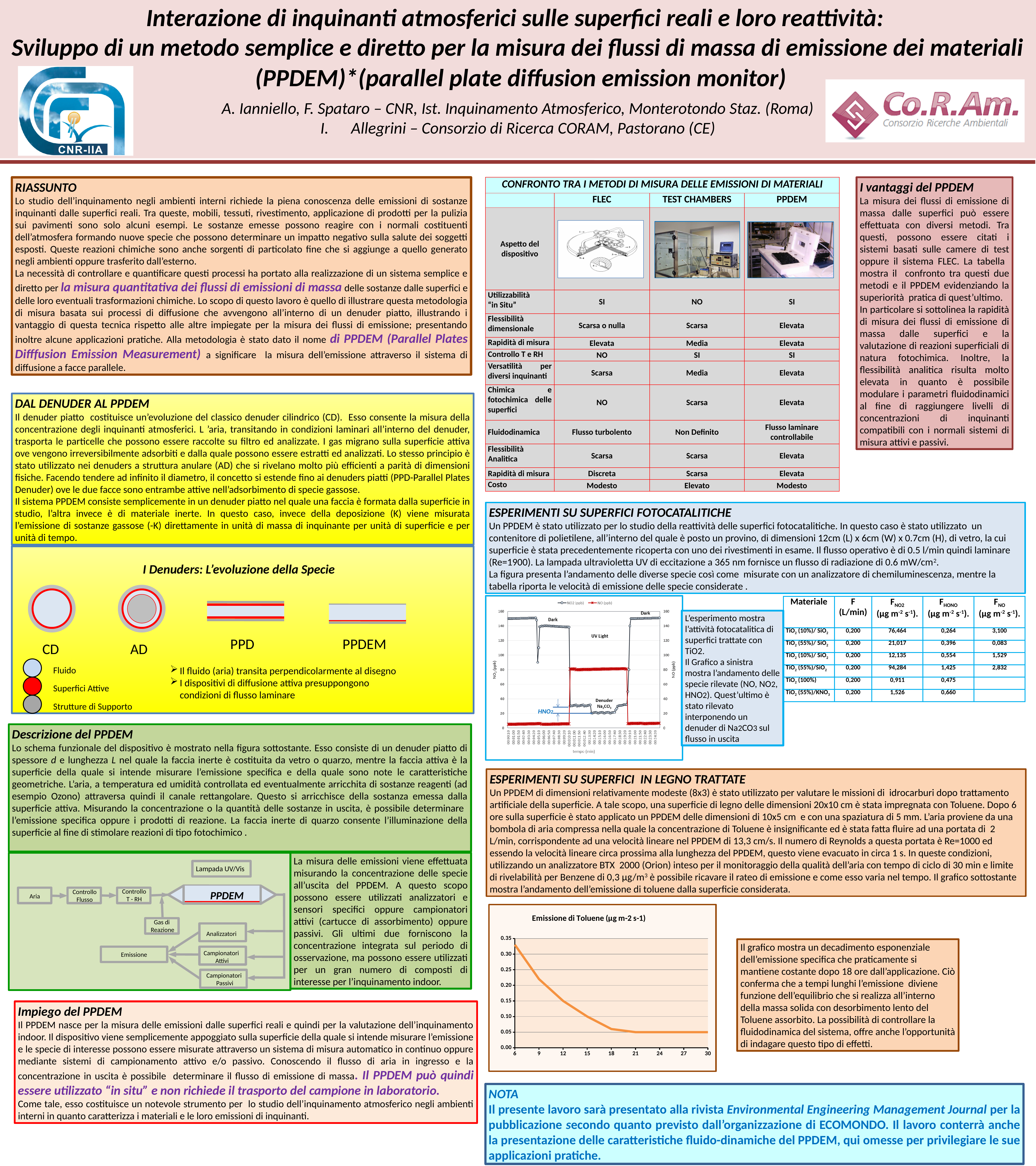
In the 'Emissione di Toluene (µg m-2 s-1)' chart, is the value at x = 9 greater or less than 0.20? greater In the 'Emissione di Toluene (µg m-2 s-1)' chart, is the value at x = 30 greater or less than 0.10? less In the NO2/NO chart, during the 'Dark' period at the start, which series has the higher value: NO2 (ppb) or NO (ppb)? NO2 (ppb) What kind of chart is the NO2/NO chart in the 'Esperimenti su superfici fotocatalitiche' section? line chart What is the x-axis label of the NO2/NO chart in the 'Esperimenti su superfici fotocatalitiche' section? tempo (min) In the 'Emissione di Toluene (µg m-2 s-1)' chart, do the values rise or fall along the x axis? fall What kind of chart is the 'Emissione di Toluene (µg m-2 s-1)' chart? line chart In the 'Emissione di Toluene (µg m-2 s-1)' chart, which is larger: the value at x = 6 or the value at x = 21? x = 6 What is the title of the line chart in the 'Esperimenti su superfici in legno trattate' section? Emissione di Toluene (µg m-2 s-1) How many tick labels are shown on the x axis of the 'Emissione di Toluene (µg m-2 s-1)' chart? 9 In the 'Emissione di Toluene (µg m-2 s-1)' chart, is the value at x = 6 greater or less than 0.30? greater How many series does the legend list in the NO2/NO chart in the 'Esperimenti su superfici fotocatalitiche' section? 2